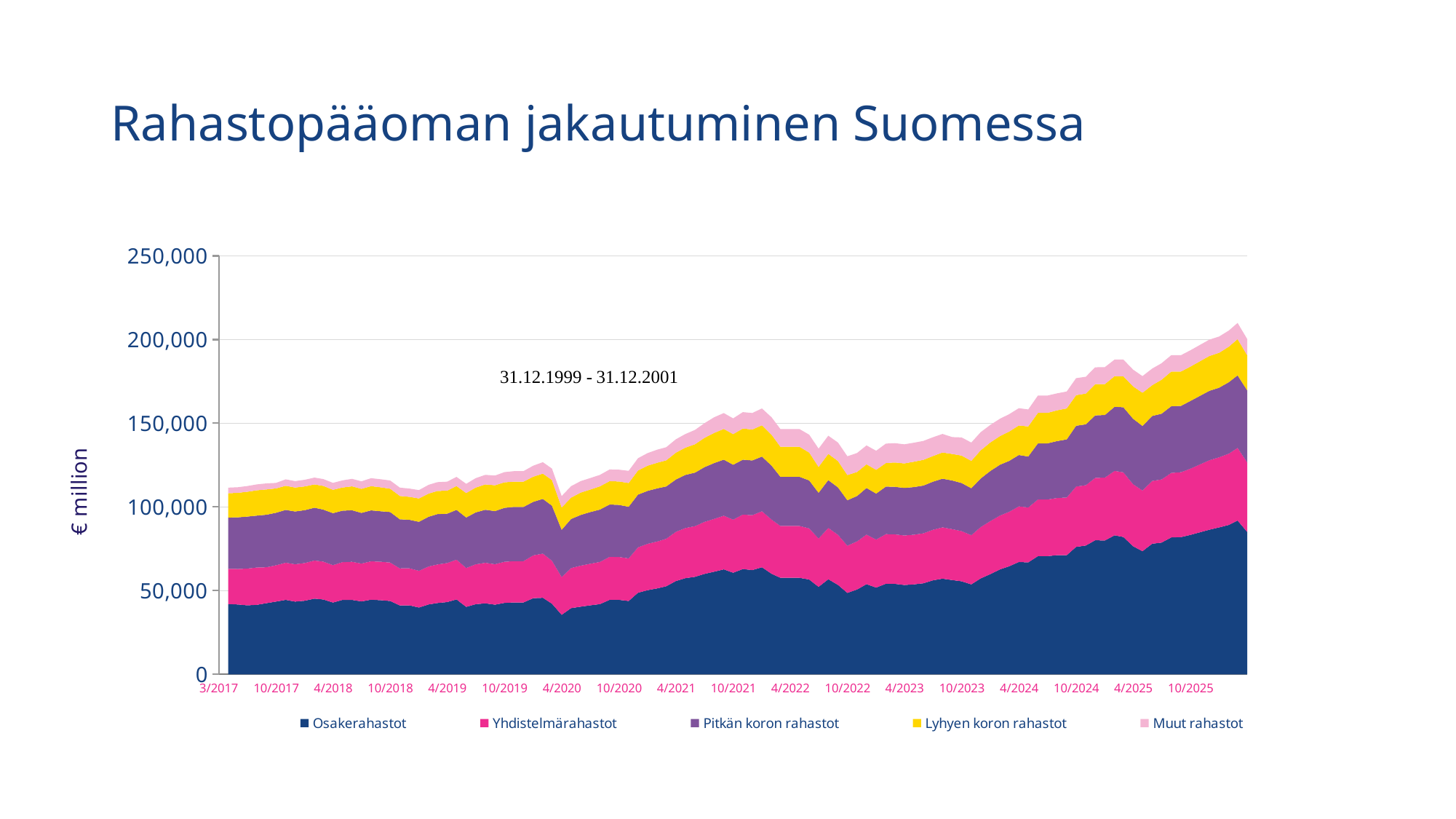
Is the total value at 4/2024 greater or less than 150,000? greater What is the title of the chart? Rahastopääoman jakautuminen Suomessa What is the label on the vertical axis? € million How many date labels are shown along the x axis? 18 Is the total value at 3/2017 greater or less than 150,000? less Does the total fund capital rise or fall overall from 3/2017 to 10/2025? Rise At 10/2025, which is larger: Osakerahastot or Muut rahastot? Osakerahastot What kind of chart is shown on the slide? Stacked area chart Which series has the smallest value at the end of the period (10/2025)? Muut rahastot Is the value for Osakerahastot at 3/2017 greater or less than 50,000? less How many series does the legend list? 5 Which series has the largest value at the end of the period (10/2025)? Osakerahastot